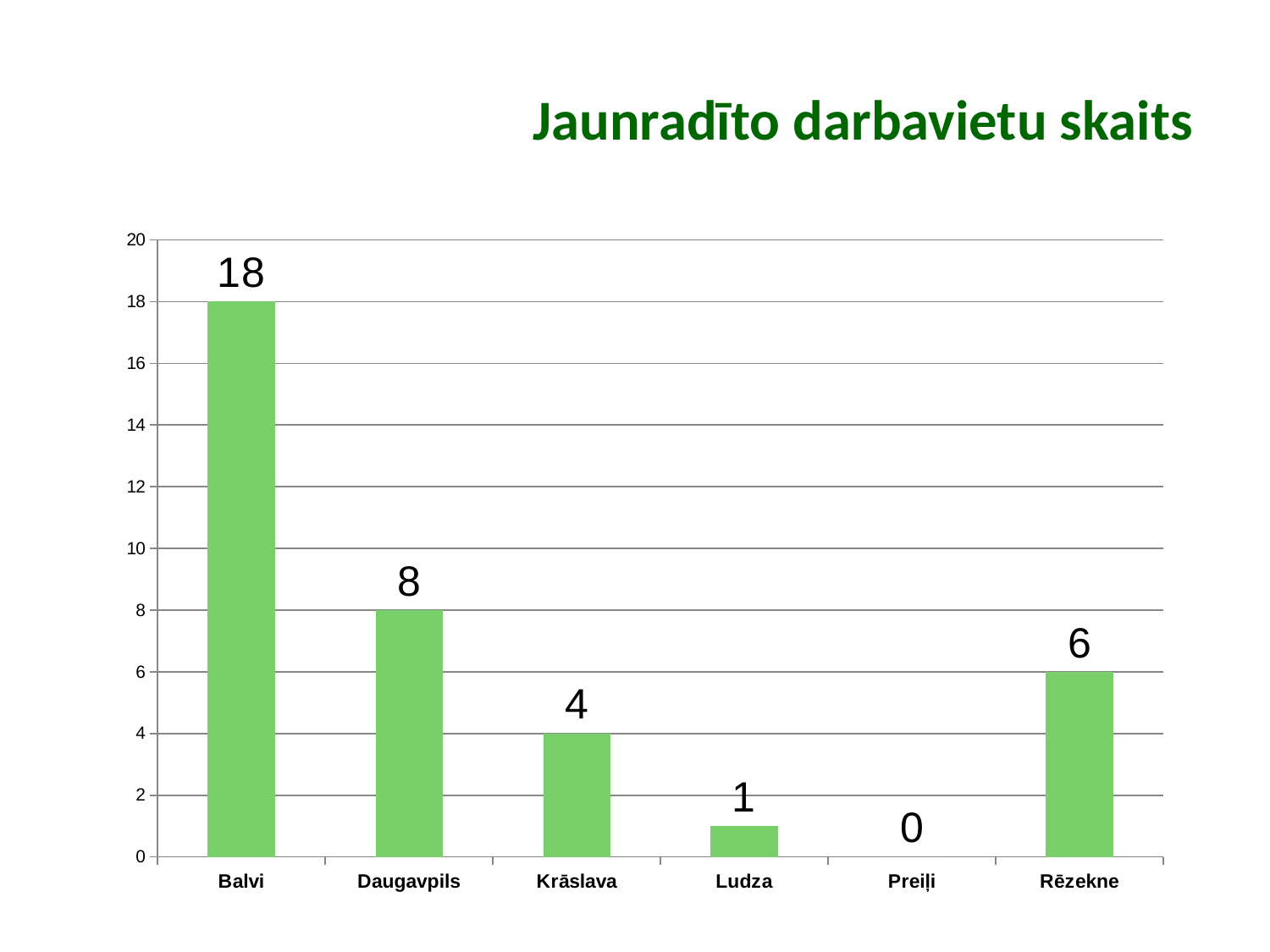
Which category has the highest value? Balvi How many categories are shown on the x axis? 6 Which is larger, the value for Krāslava or the value for Rēzekne? Rēzekne Which category has the lowest value? Preiļi What is the value for Balvi? 18 What kind of chart is shown on the slide? bar chart What is the value for Preiļi? 0 What is the value for Rēzekne? 6 What is the value for Daugavpils? 8 What is the difference between the values for Balvi and Daugavpils? 10 Is the value for Ludza greater or less than 2? less What is the title of the slide? Jaunradīto darbavietu skaits